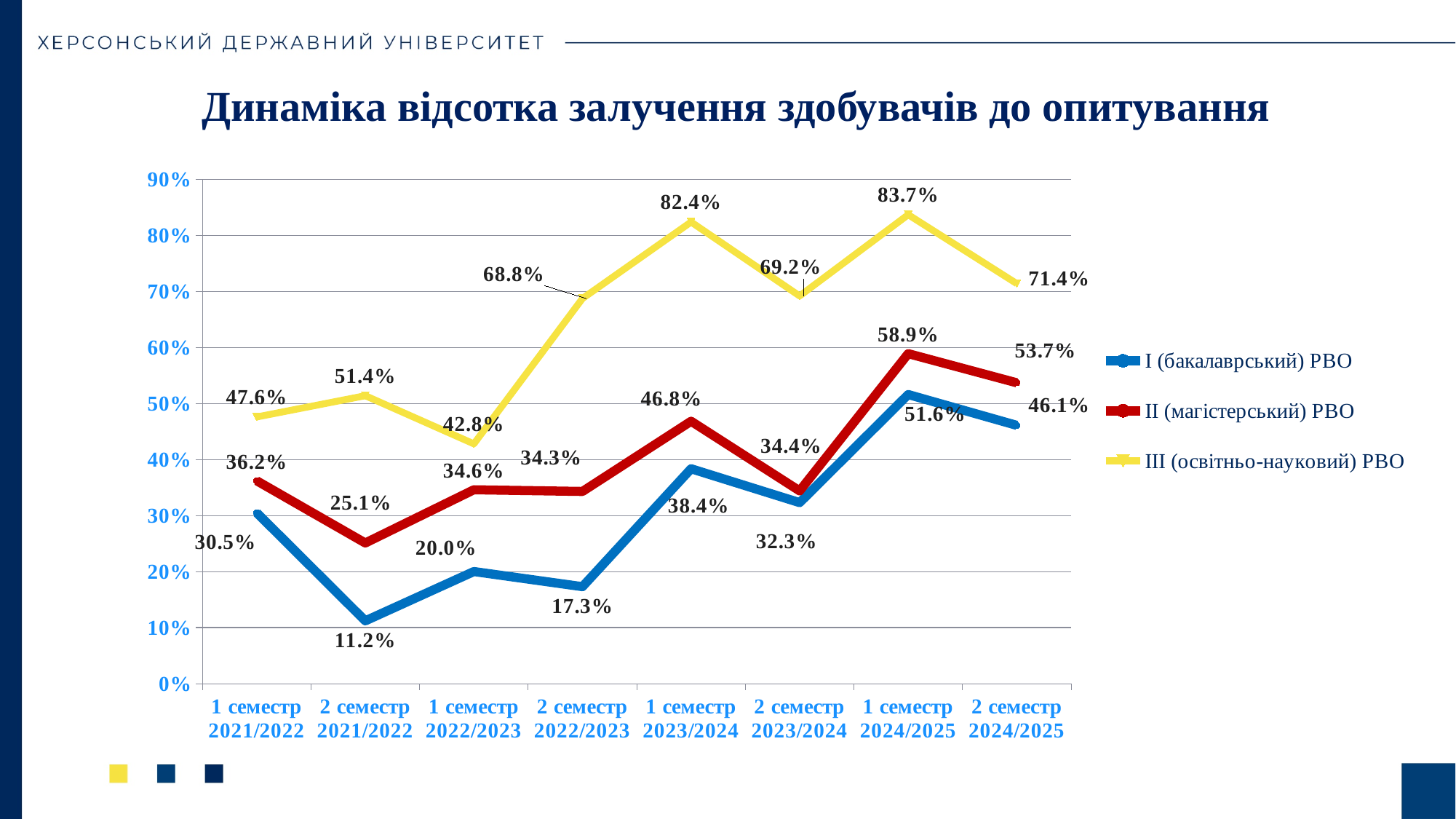
In which semester does III (освітньо-науковий) РВО reach its highest value? 1 семестр 2024/2025 How many semesters are shown on the x axis? 8 How many series does the legend list? 3 In which semester does I (бакалаврський) РВО have its lowest value? 2 семестр 2021/2022 What is the value for III (освітньо-науковий) РВО in 1 семестр 2023/2024? 82.4% What is the difference between III (освітньо-науковий) РВО and I (бакалаврський) РВО in 1 семестр 2023/2024? 44.0% What is the value for II (магістерський) РВО in 2 семестр 2024/2025? 53.7% Which series has the higher value in 2 семестр 2023/2024: I (бакалаврський) РВО or II (магістерський) РВО? II (магістерський) РВО What kind of chart is shown on the slide? Line chart What is the value for I (бакалаврський) РВО in 2 семестр 2021/2022? 11.2% Does the value for II (магістерський) РВО rise or fall from 1 семестр 2024/2025 to 2 семестр 2024/2025? Fall What is the title of the chart? Динаміка відсотка залучення здобувачів до опитування